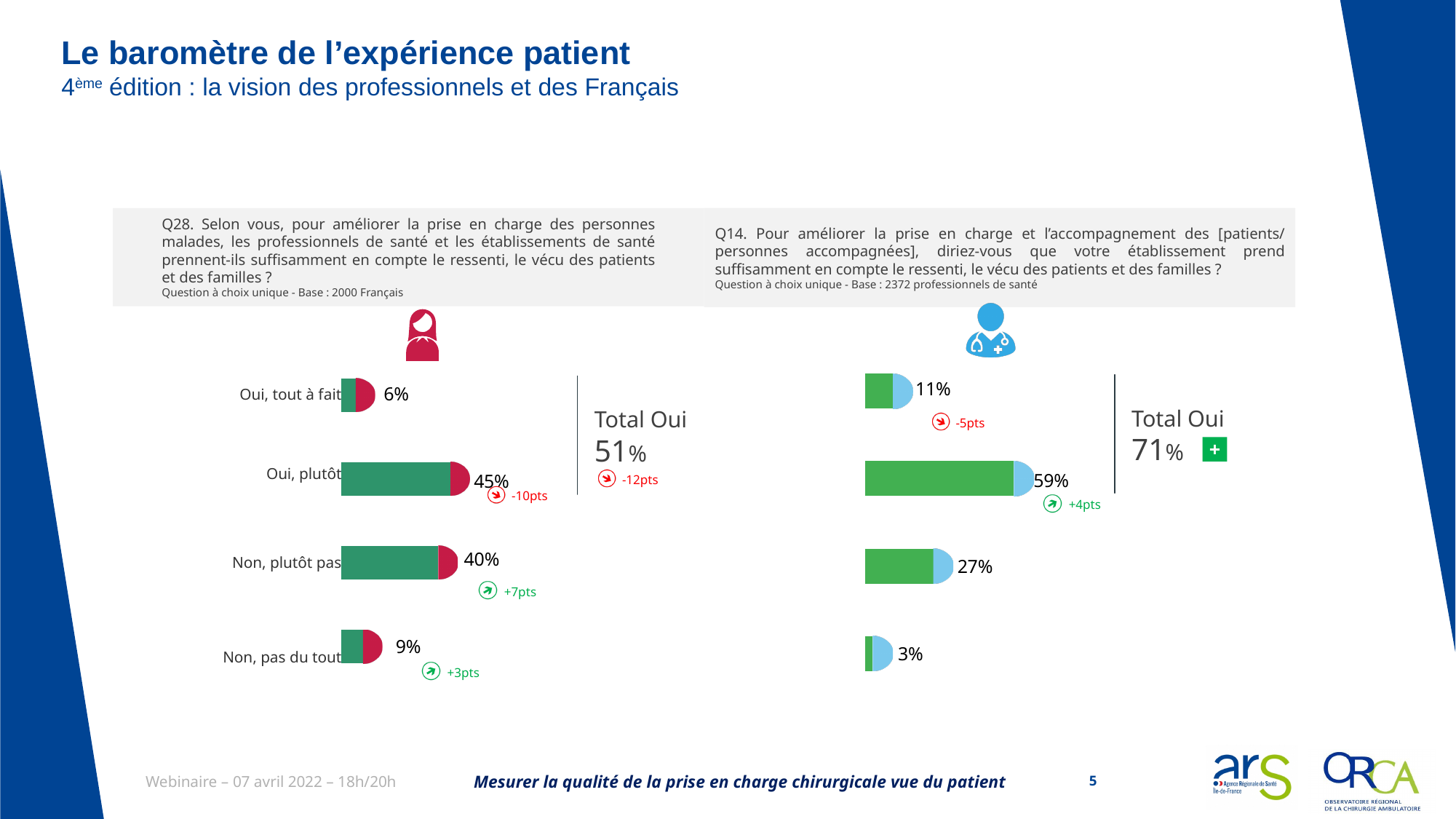
On the right chart (Q14, professionnels de santé), what is the value of the bottom bar? 3% On the right chart (Q14, professionnels de santé), what is the "Total Oui" shown? 71% What type of chart is used on the left (Q28, Français)? bar chart Which is larger: the top bar of the left chart (6%) or the top bar of the right chart (11%)? the right chart (11%) On the left chart (Q28, Français), what is the "Total Oui" shown? 51% How many bars does the left chart (Q28, Français) have? 4 On the left chart (Q28, Français), which category has the lowest value? Oui, tout à fait On the left chart (Q28, Français), what is the difference between "Oui, plutôt" and "Non, plutôt pas"? 5% On the left chart (Q28, Français), what is the value for "Non, pas du tout"? 9% On the left chart (Q28, Français), which category has the highest value? Oui, plutôt On the left chart (Q28, Français), what is the value for "Oui, plutôt"? 45% On the right chart (Q14, professionnels de santé), what is the value of the second bar from the top? 59%